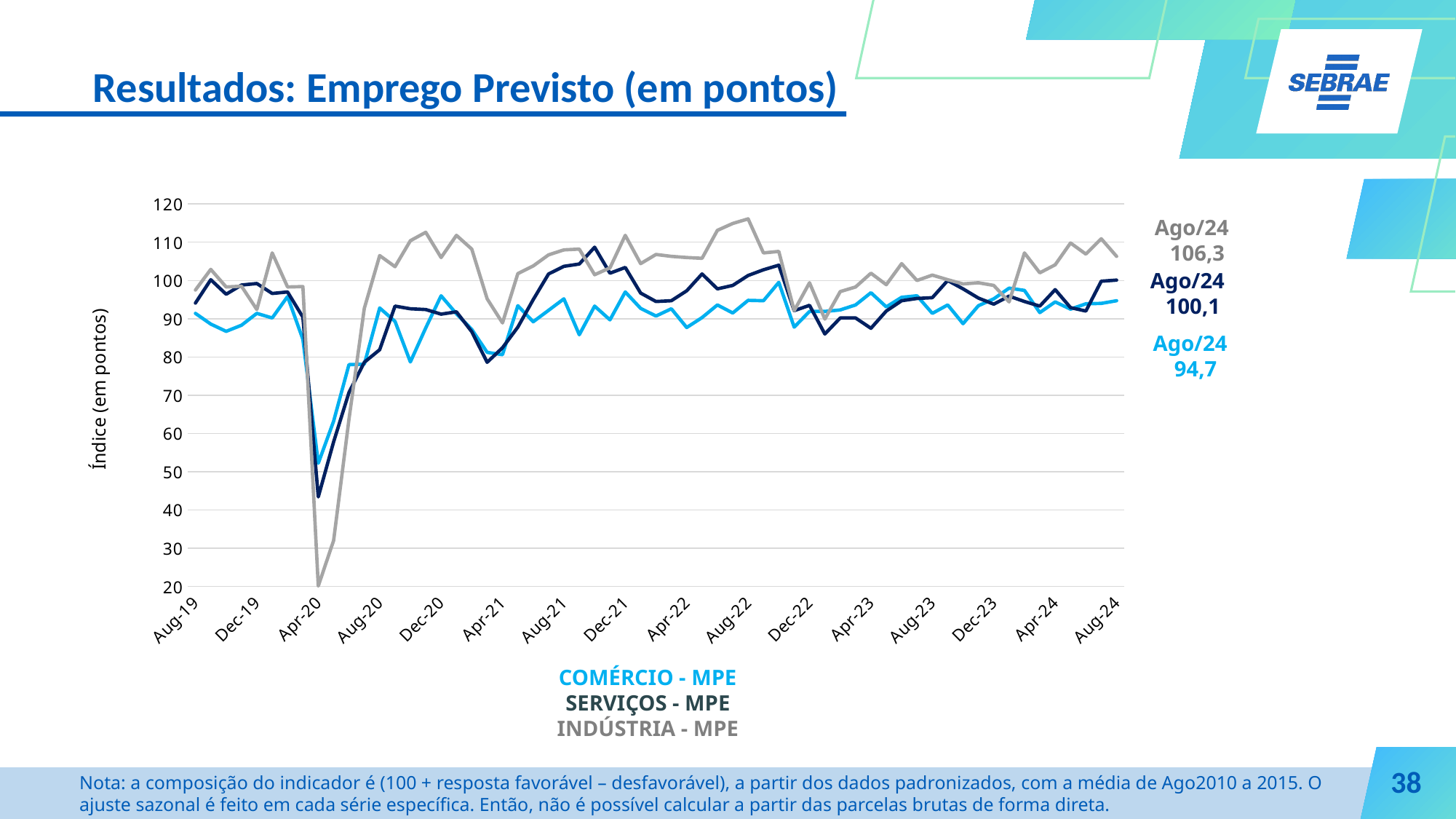
Which series has the lowest value in Ago/24? COMÉRCIO - MPE What is the difference between the Ago/24 values of INDÚSTRIA - MPE and COMÉRCIO - MPE? 11,6 What is the difference between the Ago/24 values of INDÚSTRIA - MPE and SERVIÇOS - MPE? 6,2 Is the lowest value of the INDÚSTRIA - MPE line, around Apr-20, greater or less than 30? less What is the value for SERVIÇOS - MPE in Ago/24? 100,1 What kind of chart is shown on the slide? line chart What is the label of the vertical axis? Índice (em pontos) What is the value for INDÚSTRIA - MPE in Ago/24? 106,3 Which series has the highest value in Ago/24? INDÚSTRIA - MPE In Ago/24, which is larger: SERVIÇOS - MPE or COMÉRCIO - MPE? SERVIÇOS - MPE How many series does the chart's legend list? 3 What is the value for COMÉRCIO - MPE in Ago/24? 94,7